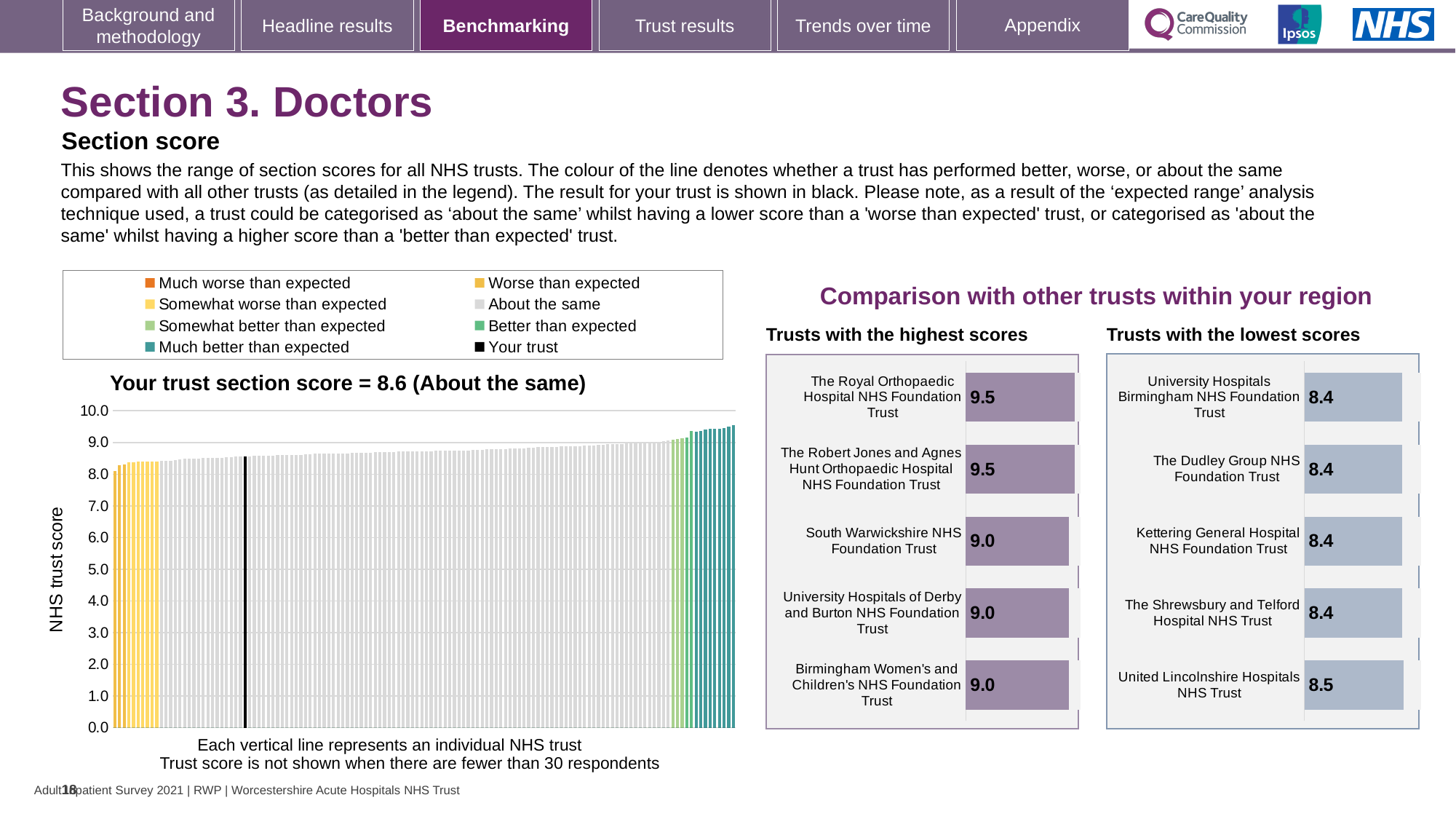
In the 'Trusts with the highest scores' chart, what is the difference between the score for The Royal Orthopaedic Hospital NHS Foundation Trust and the score for Birmingham Women's and Children's NHS Foundation Trust? 0.5 In the 'Your trust section score' chart, what kind of chart is shown? bar chart In the 'Trusts with the lowest scores' chart, what is the score for United Lincolnshire Hospitals NHS Trust? 8.5 In the 'Your trust section score' chart, what is the section score for your trust? 8.6 In the 'Your trust section score' chart, what is the label on the vertical axis? NHS trust score Which is larger: the score for The Royal Orthopaedic Hospital NHS Foundation Trust in the 'Trusts with the highest scores' chart, or the score for United Lincolnshire Hospitals NHS Trust in the 'Trusts with the lowest scores' chart? The Royal Orthopaedic Hospital NHS Foundation Trust In the 'Trusts with the lowest scores' chart, what is the score for Kettering General Hospital NHS Foundation Trust? 8.4 In the 'Trusts with the highest scores' chart, what is the score for South Warwickshire NHS Foundation Trust? 9.0 In the 'Your trust section score' chart, how many entries does the legend list? 8 In the 'Trusts with the lowest scores' chart, which trust has the highest score? United Lincolnshire Hospitals NHS Trust In the 'Trusts with the highest scores' chart, how many trusts are listed? 5 In the 'Your trust section score' chart, do the trust scores rise or fall from left to right along the x axis? rise